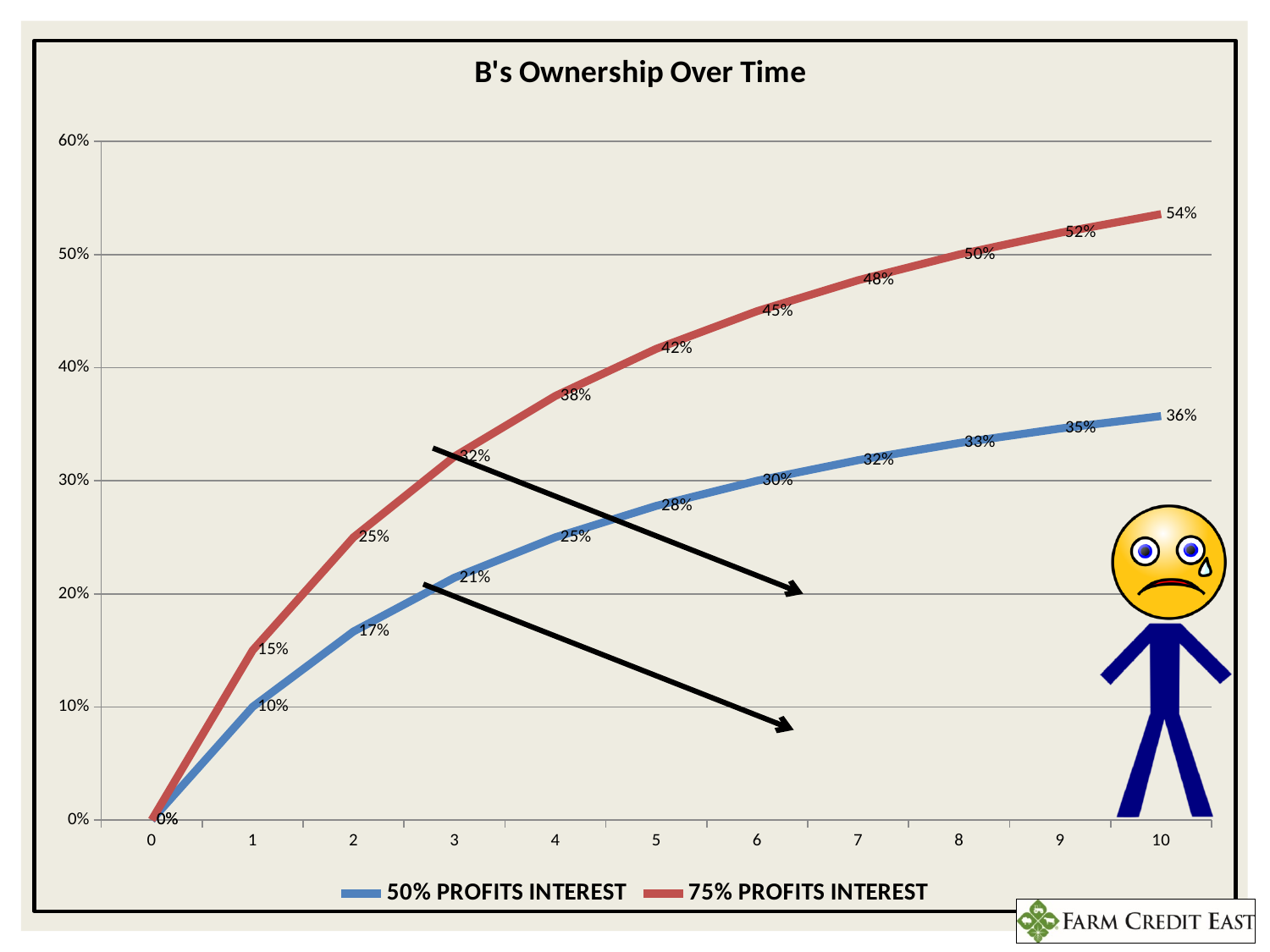
What is the value of the 50% PROFITS INTEREST series at year 10? 36% Which series has the higher value at year 5, 50% PROFITS INTEREST or 75% PROFITS INTEREST? 75% PROFITS INTEREST What colour is the line for the 75% PROFITS INTEREST series? red Do the values of the 50% PROFITS INTEREST series rise or fall as the years increase? rise What is the value of the 50% PROFITS INTEREST series at year 3? 21% How many data points are plotted for each series? 11 How many series does the legend list? 2 What is the value of the 75% PROFITS INTEREST series at year 4? 38% What kind of chart is shown on the slide? line chart What is the difference between the 75% PROFITS INTEREST and 50% PROFITS INTEREST values at year 10? 18% What is the title of the chart? B's Ownership Over Time What is the value of the 75% PROFITS INTEREST series at year 10? 54%